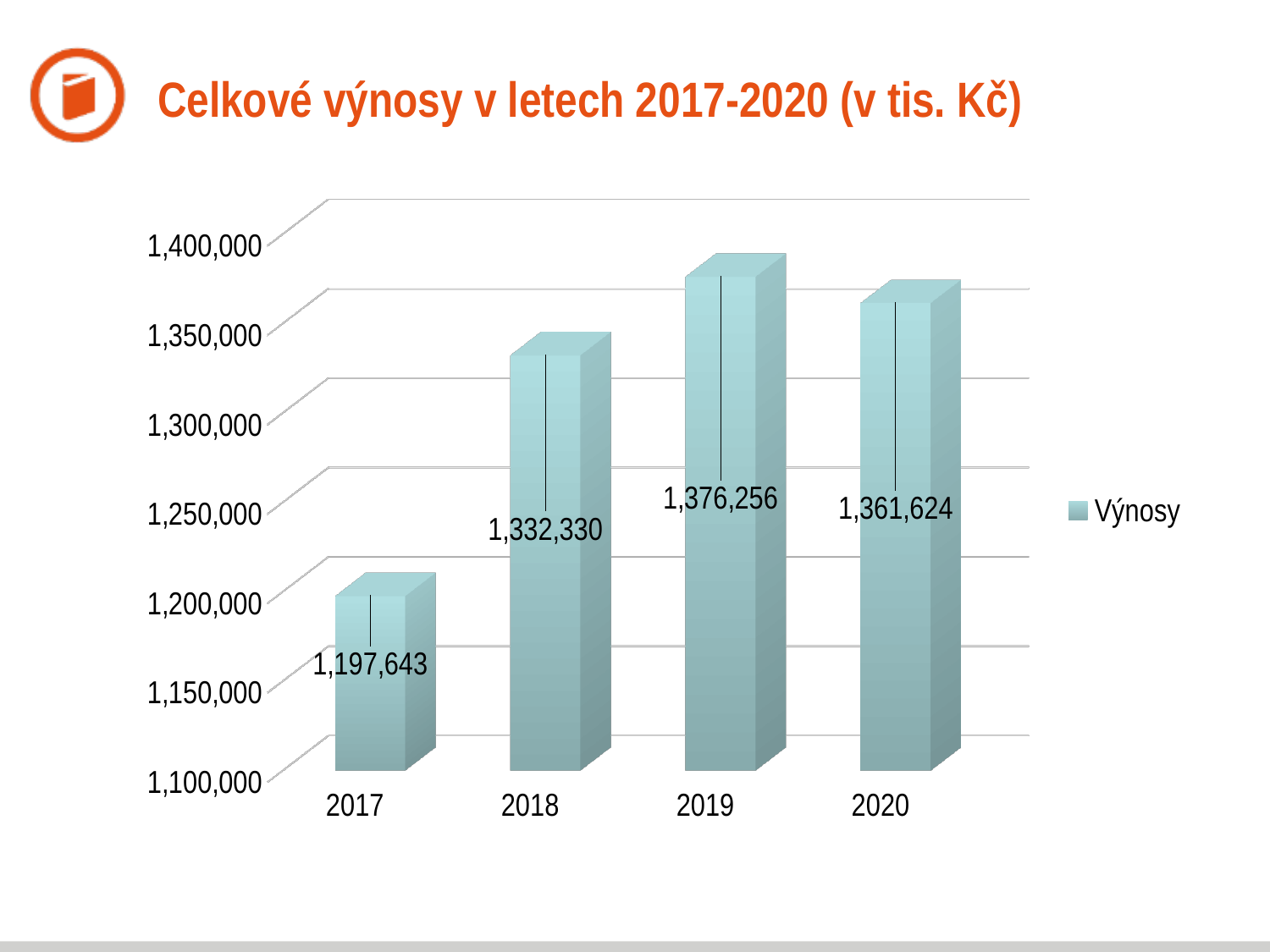
What is the difference between the values for 2019 and 2020? 14,632 How many years are shown on the x axis? 4 What is the value for 2018? 1,332,330 What is the name of the series listed in the legend? Výnosy What kind of chart is shown on the slide? bar chart What is the value for 2019? 1,376,256 What is the difference between the values for 2018 and 2017? 134,687 What is the value for 2020? 1,361,624 Which year has the lowest value? 2017 Which year has the highest value? 2019 What is the value for 2017? 1,197,643 Which is larger, the value for 2018 or the value for 2020? 2020